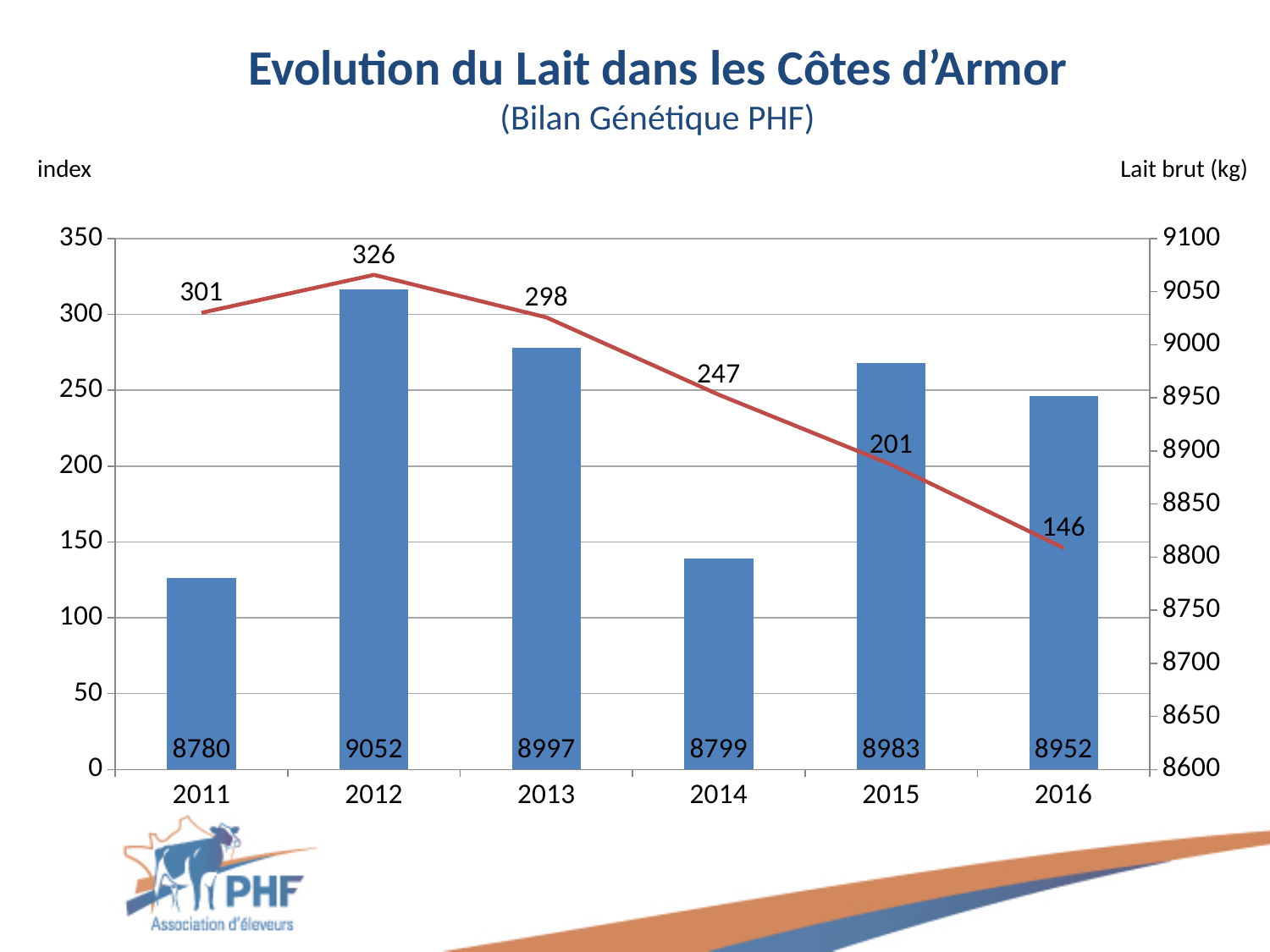
What is the index value shown on the line for 2014? 247 What is the difference between the Lait brut (kg) values for 2012 and 2011? 272 How many years are shown on the x axis? 6 What is the Lait brut (kg) value shown on the bar for 2016? 8952 From 2012 to 2016, does the index line rise or fall? fall Which year has the lowest Lait brut (kg) bar? 2011 What is the difference between the index values for 2011 and 2016? 155 What is the title of the chart? Evolution du Lait dans les Côtes d'Armor (Bilan Génétique PHF) What is the Lait brut (kg) value shown on the bar for 2012? 9052 Which year has the highest Lait brut (kg) bar? 2012 Which year has the lowest index value on the line? 2016 Which year has a larger Lait brut (kg) value, 2013 or 2015? 2013